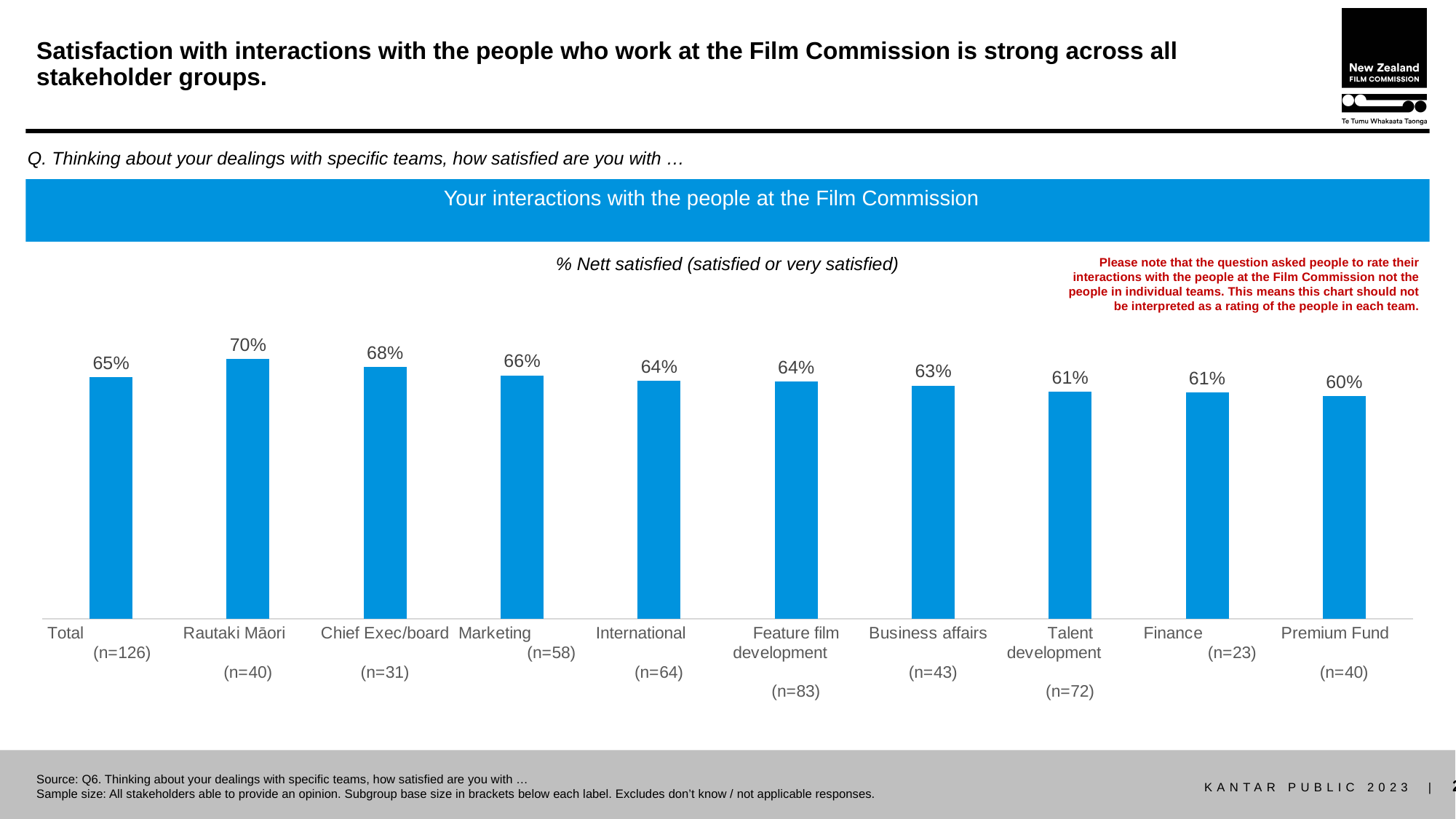
Which has a higher % nett satisfied, Chief Exec/board or Talent development? Chief Exec/board Which stakeholder group has the highest % nett satisfied? Rautaki Māori What is the difference in % nett satisfied between Chief Exec/board and Marketing? 2 percentage points What is the % nett satisfied value for Business affairs? 63% How many stakeholder groups (bars) are shown in the chart? 10 What is the % nett satisfied value for Total? 65% What is the % nett satisfied value for Rautaki Māori? 70% What is the sample size (n) shown for Feature film development? n=83 What is the % nett satisfied value for Premium Fund? 60% Which stakeholder group has the lowest % nett satisfied? Premium Fund What is the difference in % nett satisfied between Rautaki Māori and Premium Fund? 10 percentage points What type of chart is shown on the slide? Bar chart